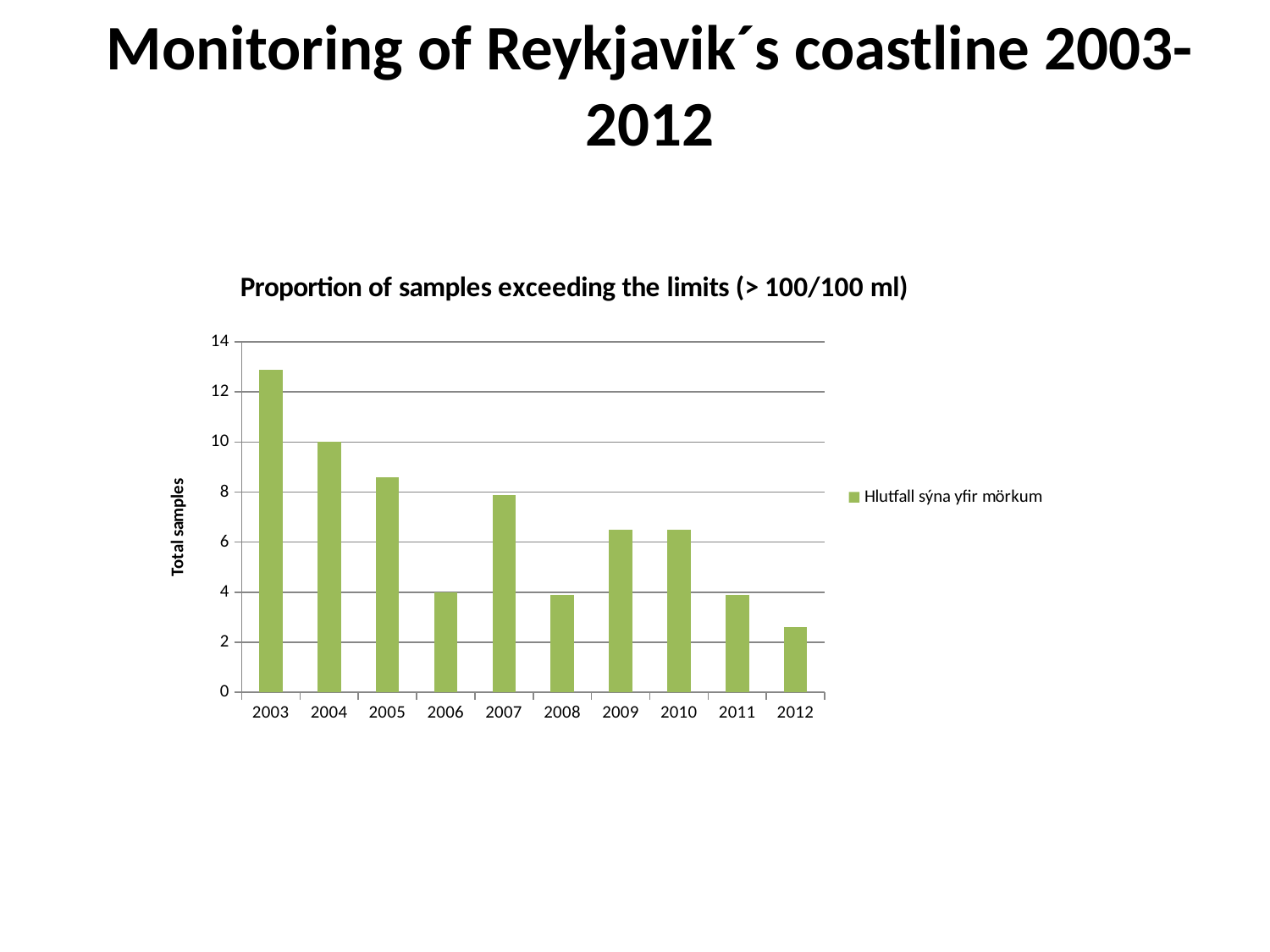
Do the values generally rise or fall from 2003 to 2012? Fall Is the value for 2012 greater or less than 2? greater Is the value for 2003 greater or less than 12? greater How many series does the legend list? 1 Which year has the larger value, 2004 or 2005? 2004 Which year has the highest value in the chart? 2003 Which year has the lowest value in the chart? 2012 What is the label of the y axis of the chart? Total samples What type of chart is shown on the slide? Bar chart Is the value for 2005 greater or less than 8? greater How many years are shown on the x axis of the chart? 10